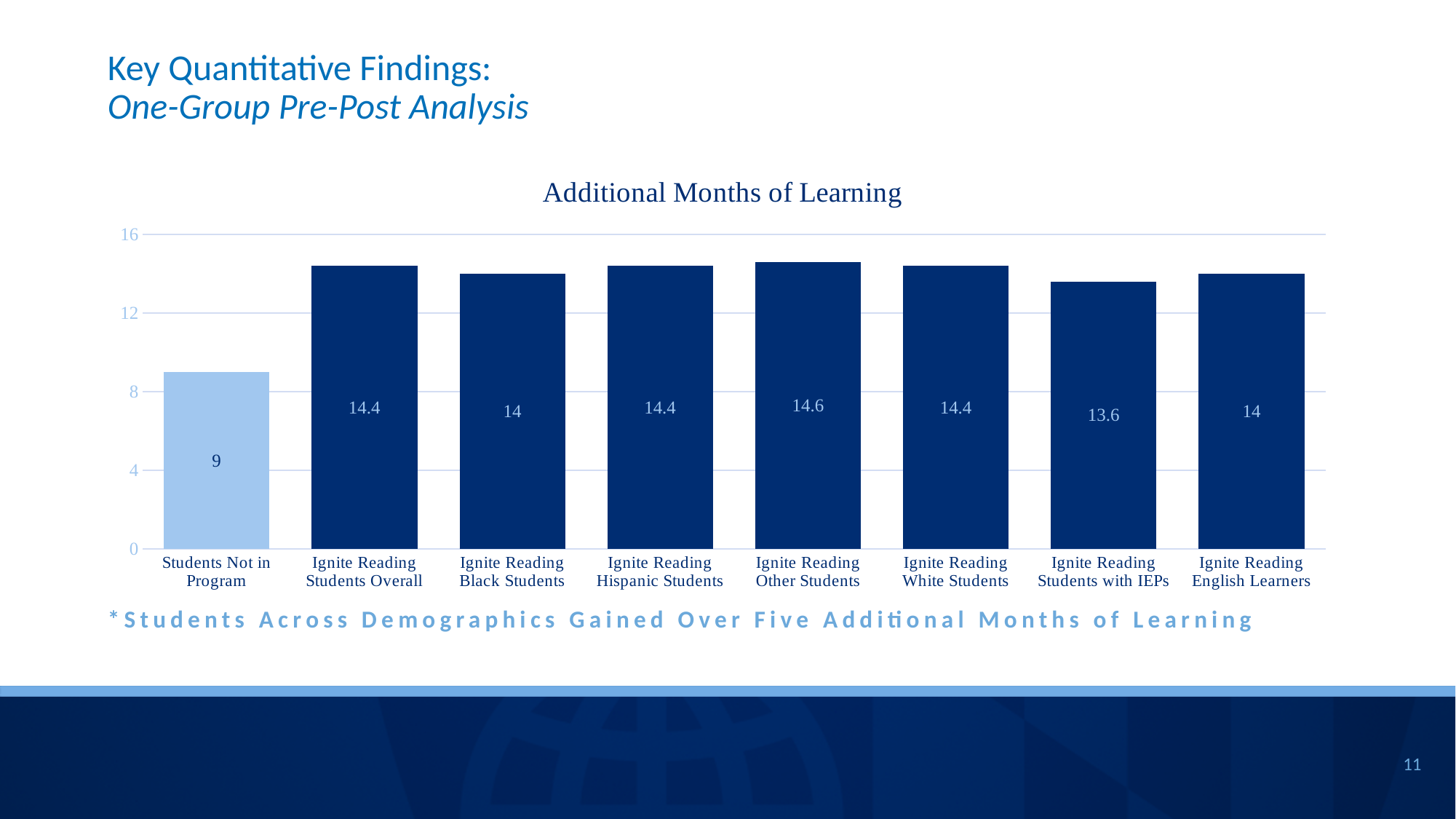
Is the value for Ignite Reading White Students greater or less than 12? greater What is the value for Ignite Reading Students with IEPs? 13.6 Which category has the lowest value? Students Not in Program Which is larger, the value for Ignite Reading Black Students or Ignite Reading Students with IEPs? Ignite Reading Black Students What is the title of the chart? Additional Months of Learning How many categories are shown on the chart? 8 What is the difference between Ignite Reading Students Overall and Students Not in Program? 5.4 What is the value for Ignite Reading Other Students? 14.6 What is the value for Ignite Reading English Learners? 14 Which category has the highest value? Ignite Reading Other Students What is the value for Students Not in Program? 9 What kind of chart is shown on the slide? Bar chart